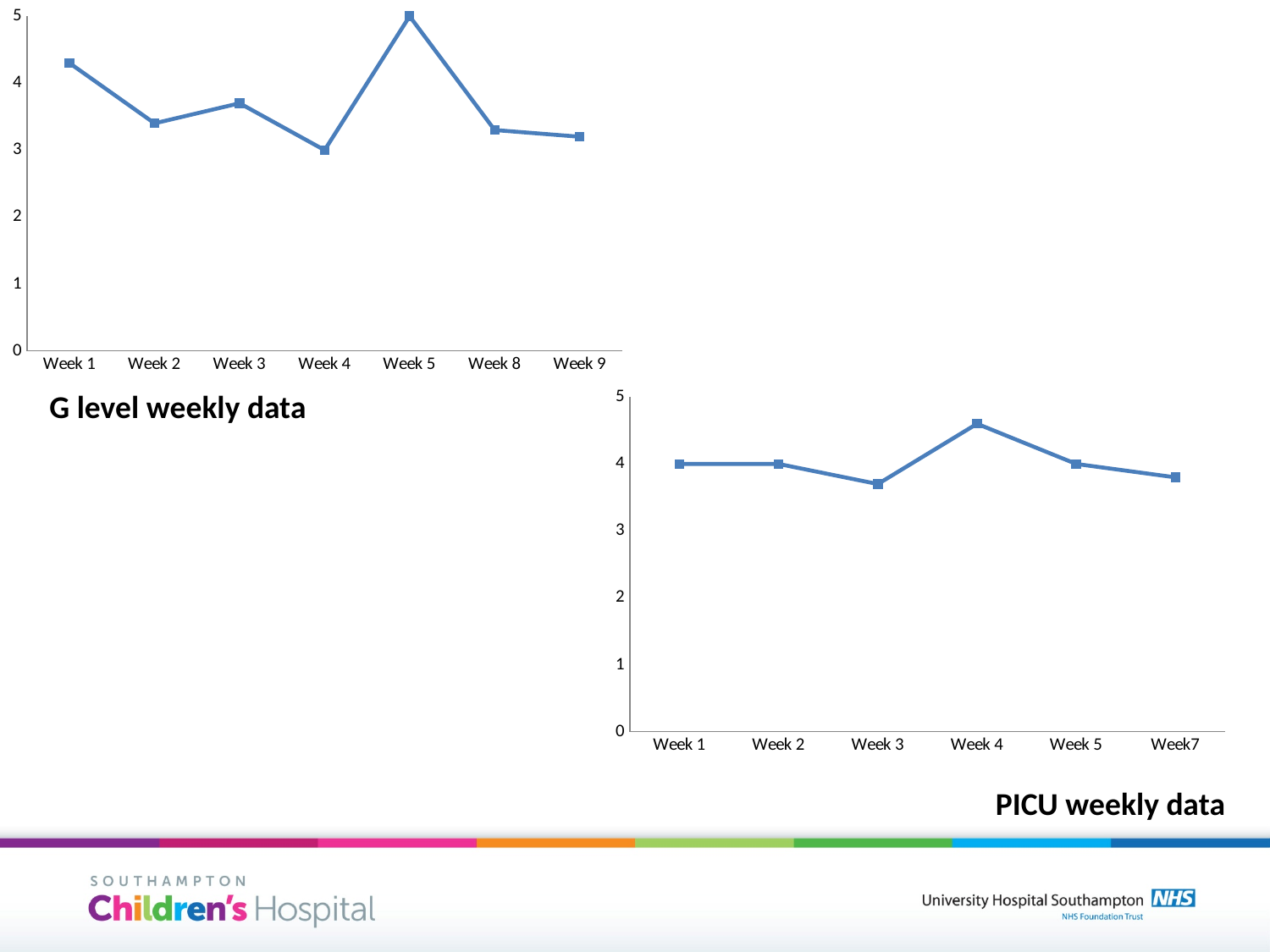
In the G level weekly data chart, is the value for Week 2 greater or less than 4? less What is the title of the chart in the lower right of the slide? PICU weekly data In the G level weekly data chart, which is larger, the value for Week 1 or the value for Week 2? Week 1 In the PICU weekly data chart, which week has the highest value? Week 4 In the G level weekly data chart, do the values rise or fall from Week 5 to Week 9? fall How many data points are plotted in the G level weekly data chart? 7 How many data points are plotted in the PICU weekly data chart? 6 In the G level weekly data chart, which week has the highest value? Week 5 In the G level weekly data chart, is the value for Week 1 greater or less than 4? greater What kind of chart is the G level weekly data chart? line chart In the G level weekly data chart, which week has the lowest value? Week 4 In the PICU weekly data chart, is the value for Week 3 greater or less than 4? less